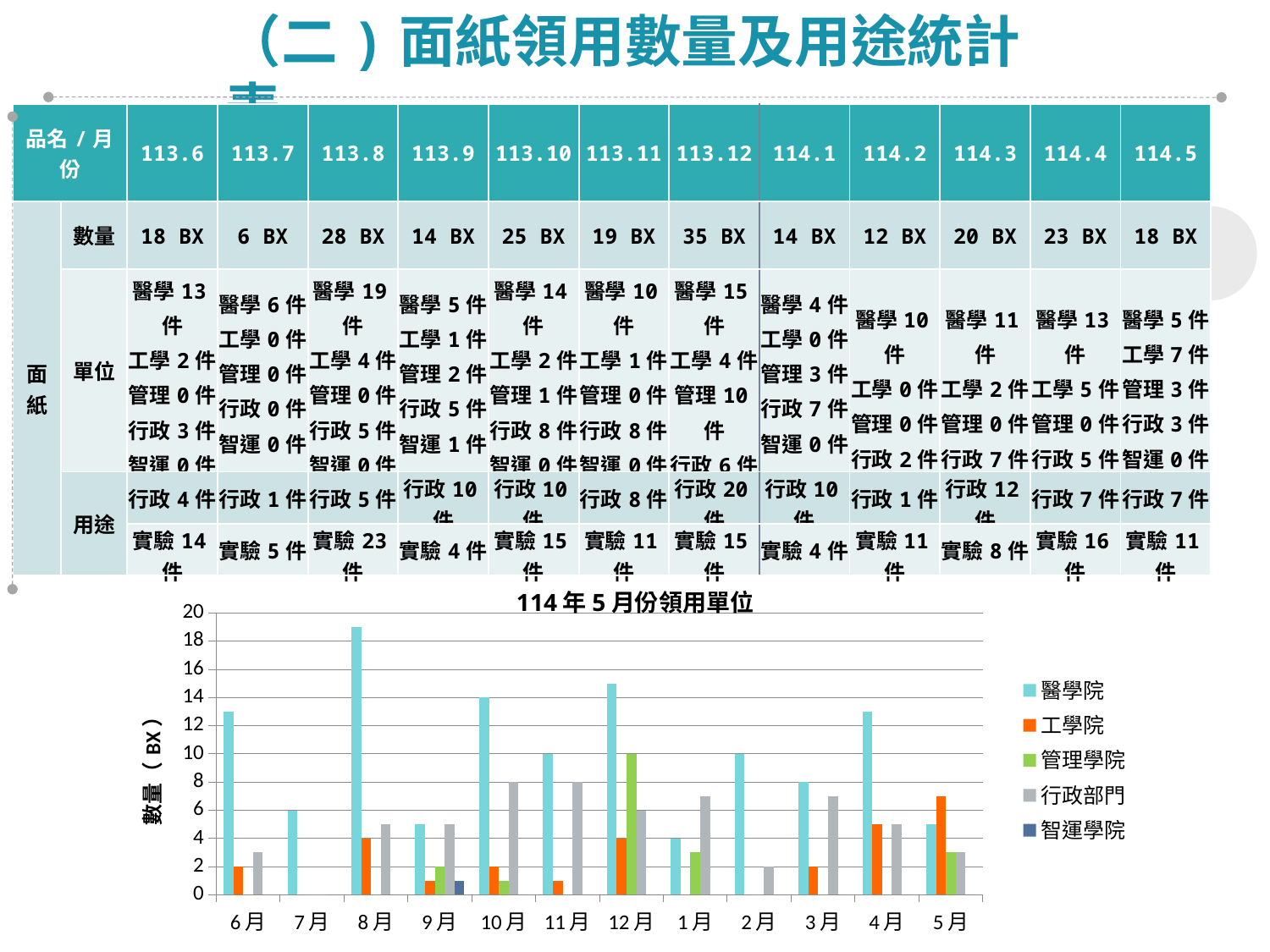
In the chart, which month has the lowest value for 醫學院? 1月 In the chart, what is the value for 醫學院 in 10月? 14 What is the title of the chart on the slide? 114年5月份領用單位 In the chart, is the value for 工學院 in 5月 greater or less than 6? greater What kind of chart is shown at the bottom of the slide? bar chart How many month categories are shown on the x axis of the chart? 12 In the chart, is the value for 醫學院 in 6月 greater or less than 10? greater In the chart, what is the value for 行政部門 in 11月? 8 In the chart, what is the value for 醫學院 in 7月? 6 In the chart, which month has the highest value for 醫學院? 8月 How many series does the chart legend list? 5 In the chart, which is larger in 12月: 管理學院 or 行政部門? 管理學院